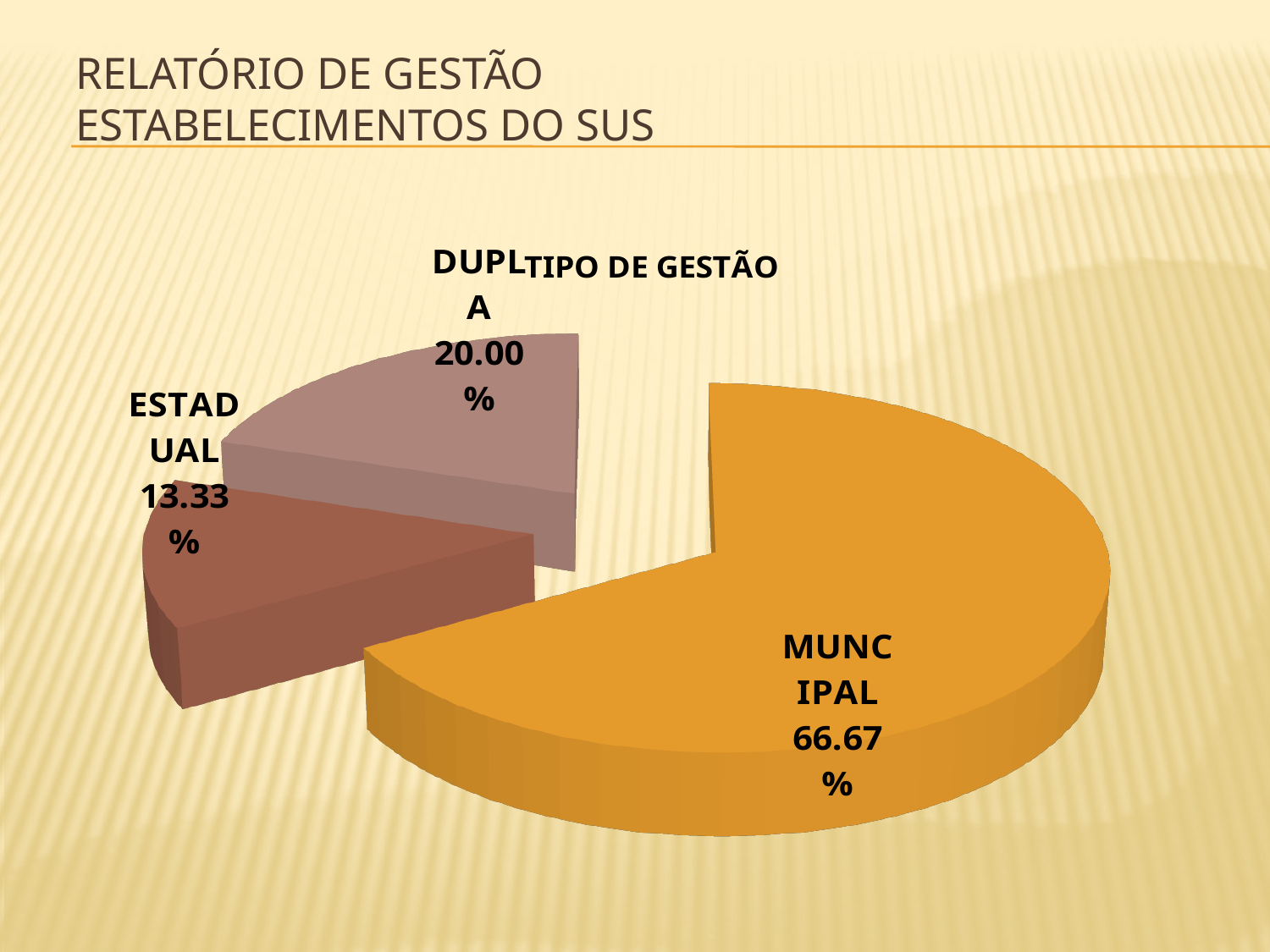
Which is larger, the DUPLA slice or the ESTADUAL slice? DUPLA What share of the pie does the MUNCIPAL slice represent? 66.67% What is the title of the chart? TIPO DE GESTÃO What share of the pie does the ESTADUAL slice represent? 13.33% What is the difference in percentage points between the MUNCIPAL slice and the DUPLA slice? 46.67 What colour is the MUNCIPAL slice of the pie? orange Which slice of the pie is the smallest? ESTADUAL What is the difference in percentage points between the DUPLA slice and the ESTADUAL slice? 6.67 What share of the pie does the DUPLA slice represent? 20.00% Which slice of the pie is the largest? MUNCIPAL How many slices does the pie chart have? 3 What kind of chart is shown on the slide? pie chart